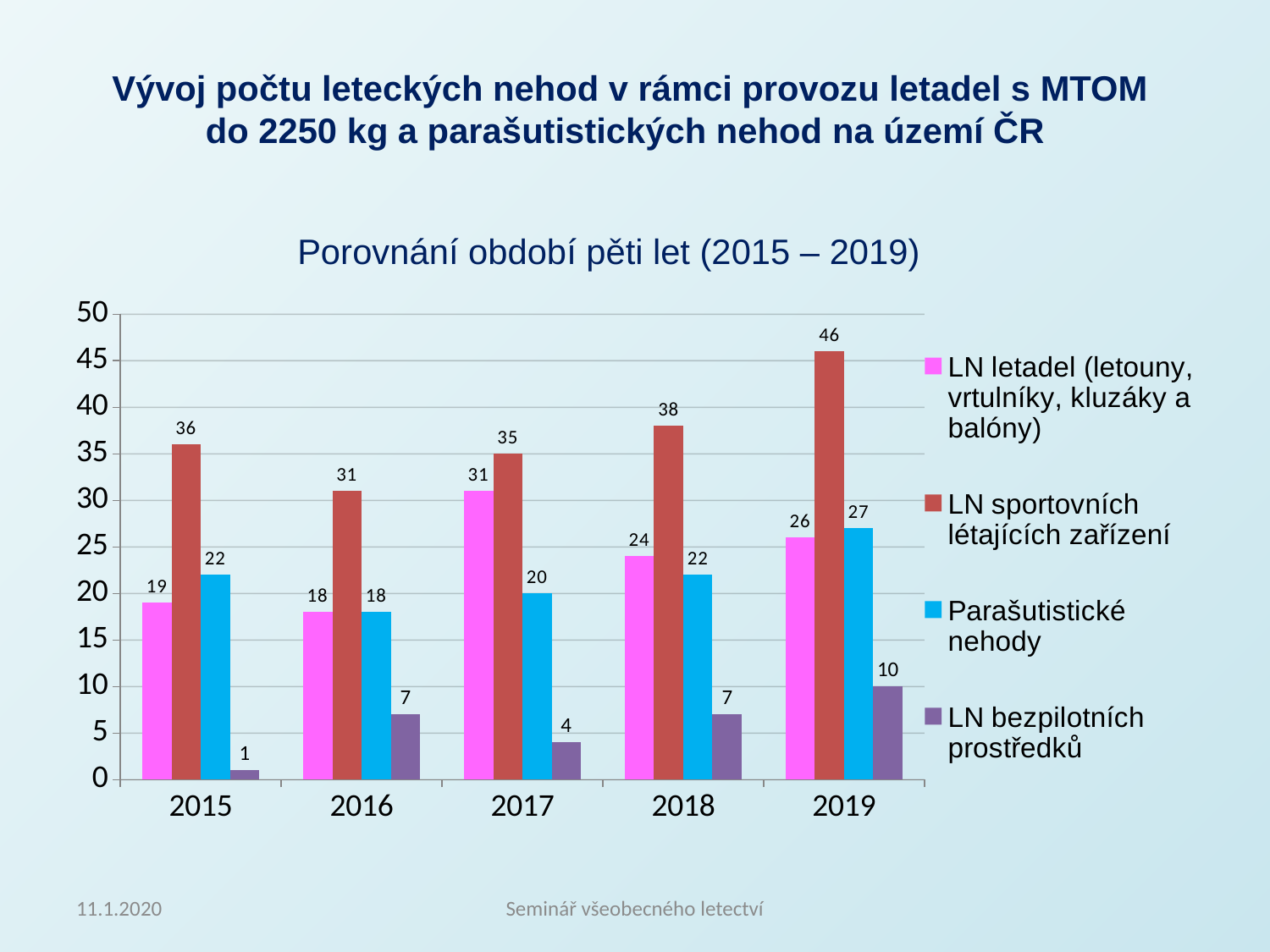
What is the difference between LN sportovních létajících zařízení in 2019 and in 2015? 10 How many series does the legend list? 4 In which year is the value for LN bezpilotních prostředků lowest? 2015 What is the value for Parašutistické nehody in 2016? 18 Does the value for LN sportovních létajících zařízení rise or fall from 2016 to 2019? Rise What is the value for LN sportovních létajících zařízení in 2019? 46 How many years are shown on the x axis? 5 What is the subtitle shown above the chart? Porovnání období pěti let (2015 – 2019) What is the value for LN bezpilotních prostředků in 2015? 1 Which is larger in 2018: LN letadel (letouny, vrtulníky, kluzáky a balóny) or Parašutistické nehody? LN letadel (letouny, vrtulníky, kluzáky a balóny) What kind of chart is shown on the slide? Bar chart In which year is the value for LN letadel (letouny, vrtulníky, kluzáky a balóny) highest? 2017